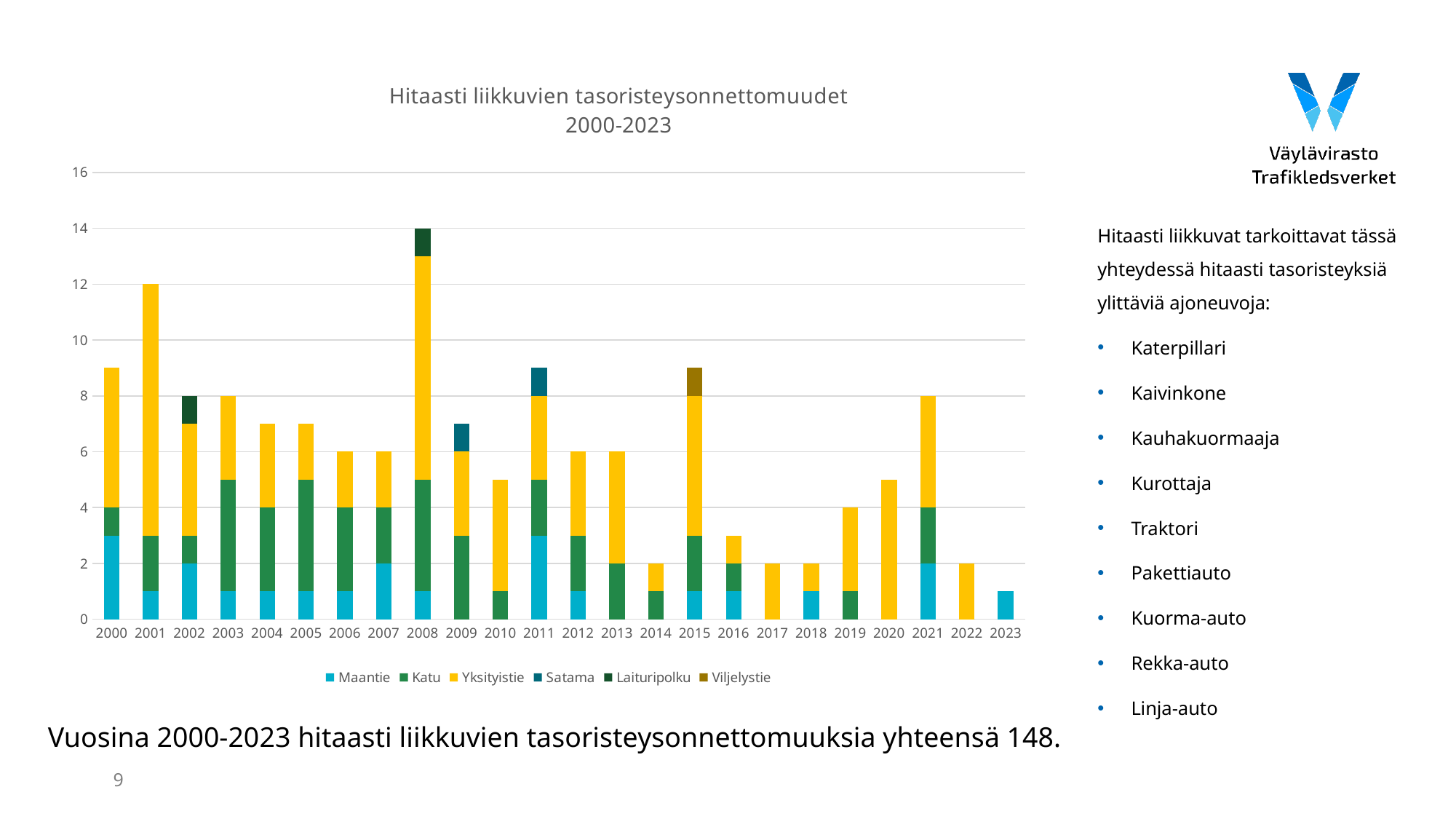
Which year has a larger total, 2000 or 2001? 2001 What is the total height of the stacked bar for 2008? 14 How many series does the legend list? 6 Is the total value for 2023 greater or less than 2? less What kind of chart is shown on the slide? Stacked bar chart What is the difference between the total for 2008 and the total for 2001? 2 How many years are shown on the x axis? 24 What is the title of the chart? Hitaasti liikkuvien tasoristeysonnettomuudet 2000-2023 Is the total value for 2015 greater or less than 8? greater Which year has the lowest total number of accidents? 2023 Which year has the highest total number of accidents? 2008 What is the total height of the stacked bar for 2001? 12